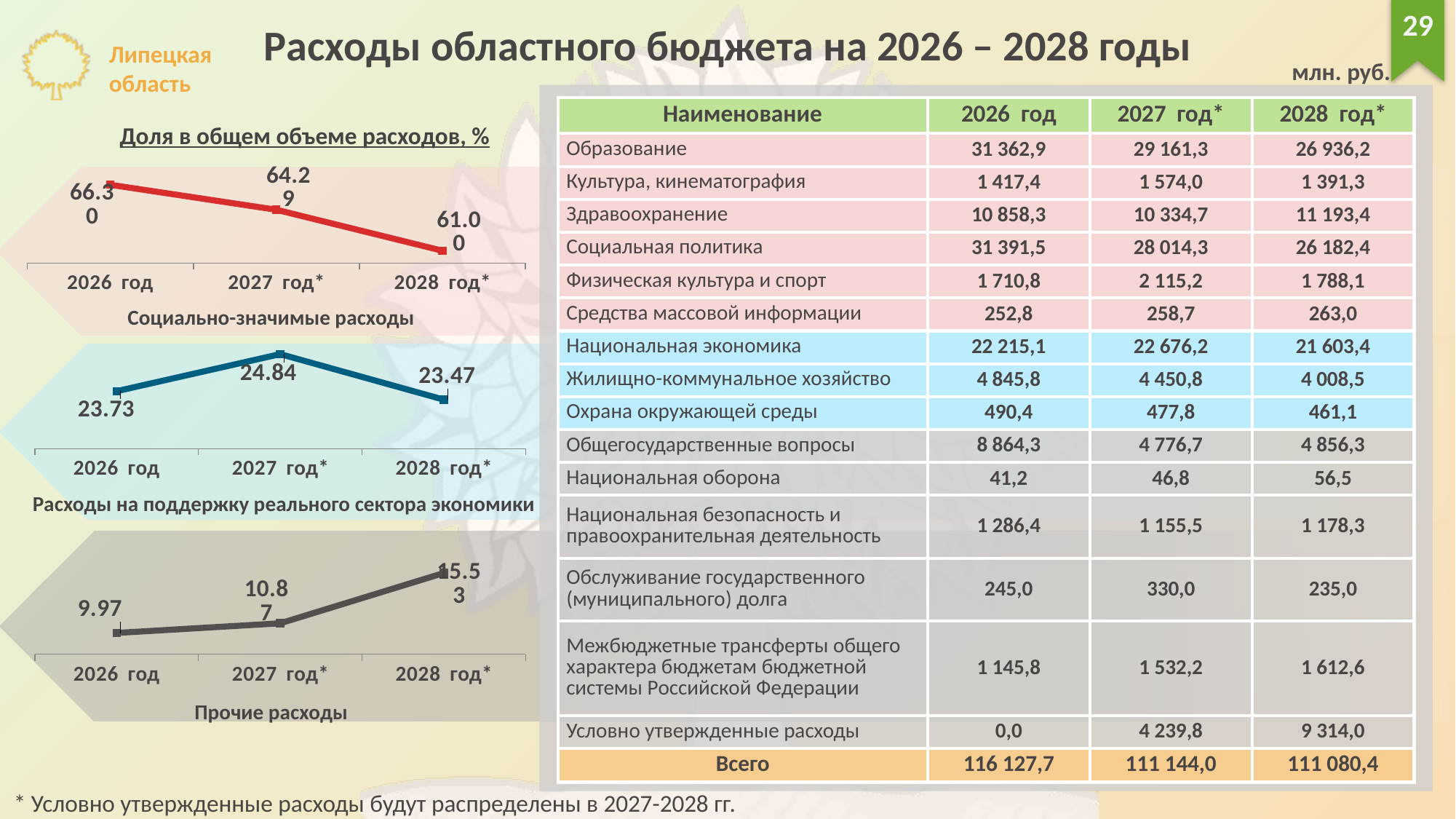
What type of chart is used for 'Расходы на поддержку реального сектора экономики'? line chart How many data points are plotted in the 'Прочие расходы' chart? 3 In the 'Расходы на поддержку реального сектора экономики' chart, what is the value for 2027 год*? 24.84 In the 'Прочие расходы' chart, which year has the lowest value? 2026 год In the 'Социально-значимые расходы' chart, what is the value for 2026 год? 66.30 In the 'Социально-значимые расходы' chart, what is the value for 2028 год*? 61.00 In the 'Прочие расходы' chart, what is the value for 2028 год*? 15.53 In the 'Социально-значимые расходы' chart, do the values rise or fall from 2026 to 2028? fall In the 'Расходы на поддержку реального сектора экономики' chart, which year has the highest value? 2027 год* In the 'Социально-значимые расходы' chart, what is the difference between the 2026 год and 2028 год* values? 5.30 In the 'Прочие расходы' chart, is the value for 2027 год* larger or smaller than the value for 2028 год*? smaller What is the common title above the three charts on the left of the slide? Доля в общем объеме расходов, %